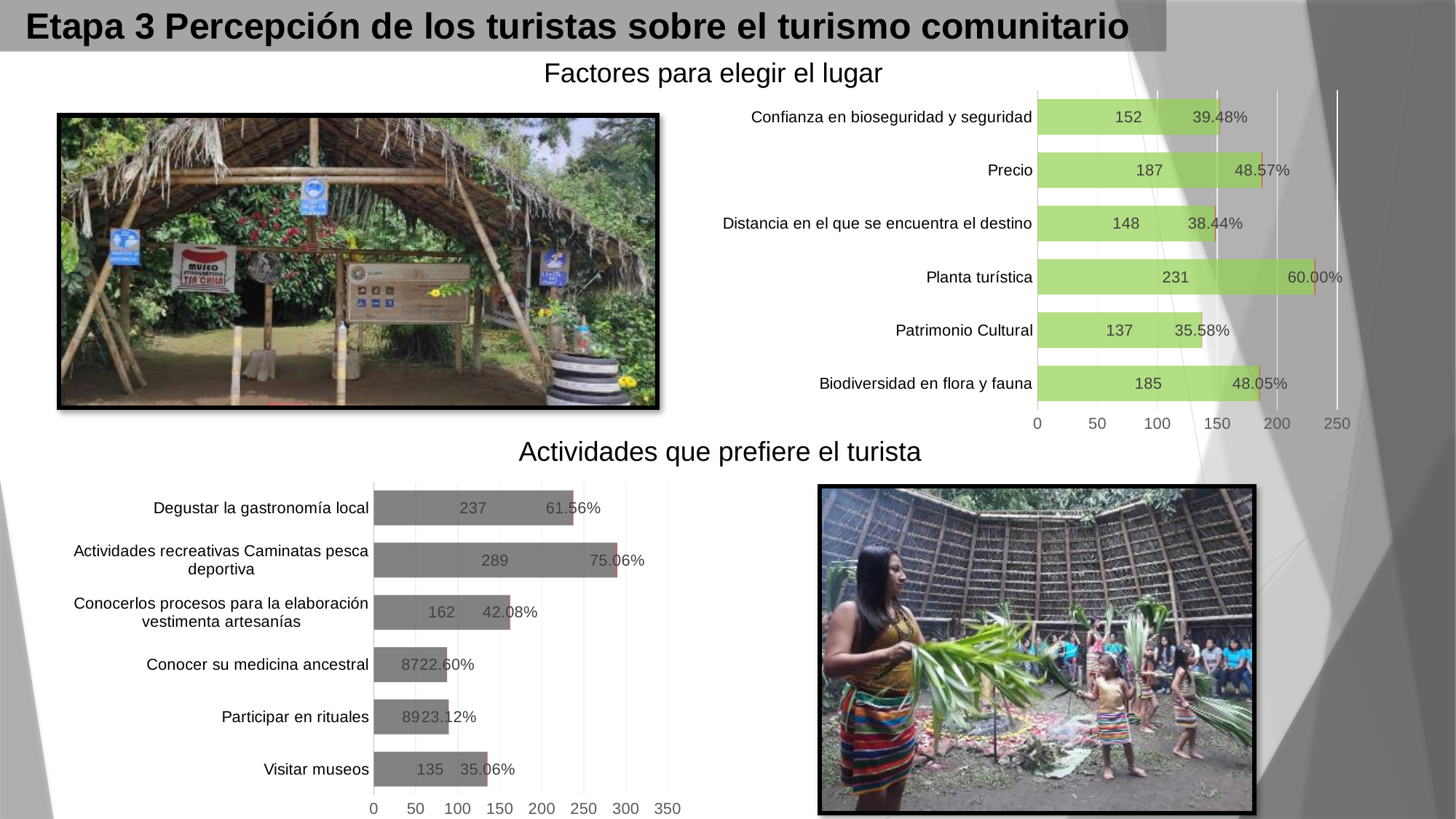
In the 'Actividades que prefiere el turista' chart, what percentage is shown for Visitar museos? 35.06% In the 'Actividades que prefiere el turista' chart, which is larger: Degustar la gastronomía local or Visitar museos? Degustar la gastronomía local In the 'Actividades que prefiere el turista' chart, what is the count for Degustar la gastronomía local? 237 In the 'Factores para elegir el lugar' chart, which factor has the highest value? Planta turística What type of chart is 'Actividades que prefiere el turista'? Bar chart In the 'Factores para elegir el lugar' chart, which factor has the lowest value? Patrimonio Cultural In the 'Factores para elegir el lugar' chart, what is the count for Precio? 187 In the 'Factores para elegir el lugar' chart, what is the difference between the counts for Planta turística and Patrimonio Cultural? 94 In the 'Actividades que prefiere el turista' chart, which activity has the highest value? Actividades recreativas Caminatas pesca deportiva In the 'Factores para elegir el lugar' chart, how many factors are listed? 6 In the 'Actividades que prefiere el turista' chart, is the value for Participar en rituales greater or less than 100? less In the 'Factores para elegir el lugar' chart, what percentage is shown for Planta turística? 60.00%